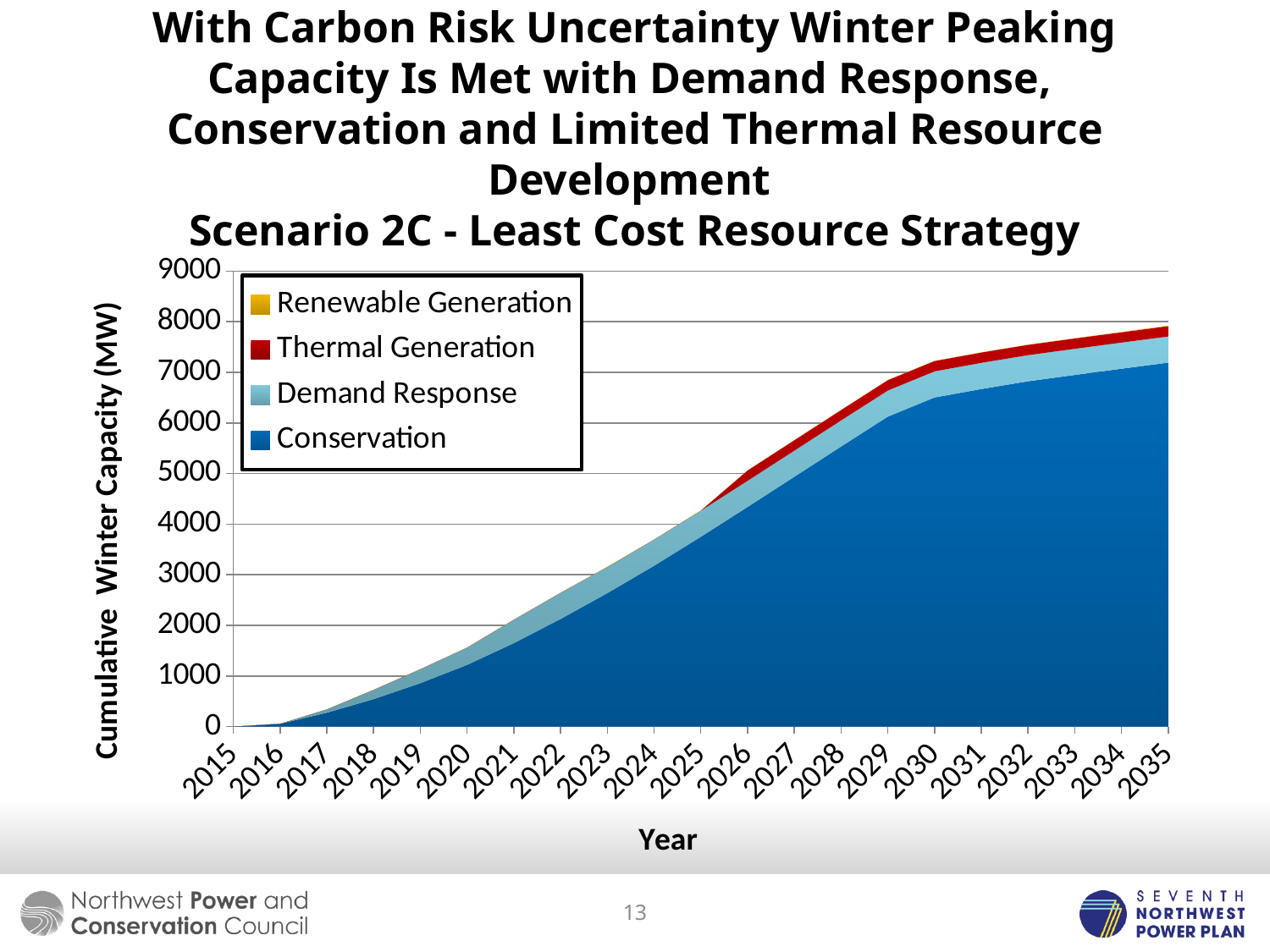
Is the total cumulative winter capacity in 2025 greater or less than 4000 MW? greater How many series does the legend list? 4 What is the title of the y axis? Cumulative Winter Capacity (MW) Is the total cumulative winter capacity in 2035 greater or less than 7000 MW? greater Is the total cumulative winter capacity in 2030 greater or less than 6000 MW? greater How many years are shown along the x axis? 21 Does the total cumulative winter capacity rise or fall from 2015 to 2035? Rise Which series contributes the largest share of the cumulative winter capacity? Conservation What kind of chart is shown on the slide? Stacked area chart Which year has the lowest total cumulative winter capacity? 2015 Which year has the highest total cumulative winter capacity? 2035